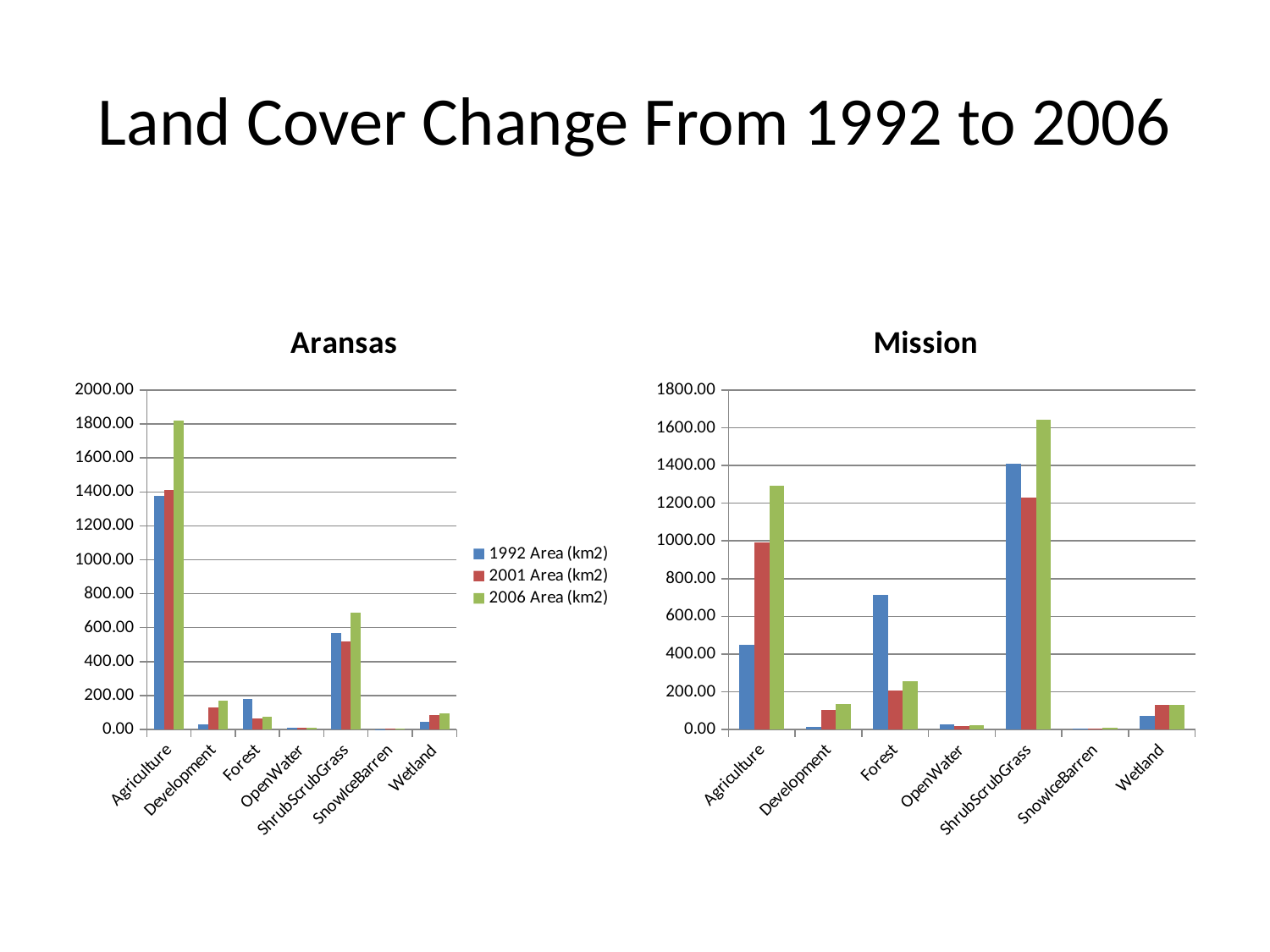
In the Mission chart, is the 2006 Area (km2) value for Agriculture greater or less than 1200.00? greater In the Aransas chart, is the 2006 Area (km2) value for Agriculture greater or less than 1600.00? greater In the Mission chart, is the 1992 Area (km2) value for Forest greater or less than 600.00? greater In the Mission chart, do the Agriculture values rise or fall from 1992 to 2006? rise In the Aransas chart, which category has the tallest bar? Agriculture In the Mission chart, which is larger for Forest: the 1992 Area (km2) value or the 2001 Area (km2) value? 1992 Area (km2) What kind of chart is the Aransas chart? bar chart In the Aransas chart, which is larger for 2006 Area (km2): Development or Forest? Development How many series does the legend list for the Aransas chart? 3 In the Mission chart, which category has the tallest bar? ShrubScrubGrass What is the title of the slide? Land Cover Change From 1992 to 2006 How many land cover categories are shown on the x axis of the Mission chart? 7